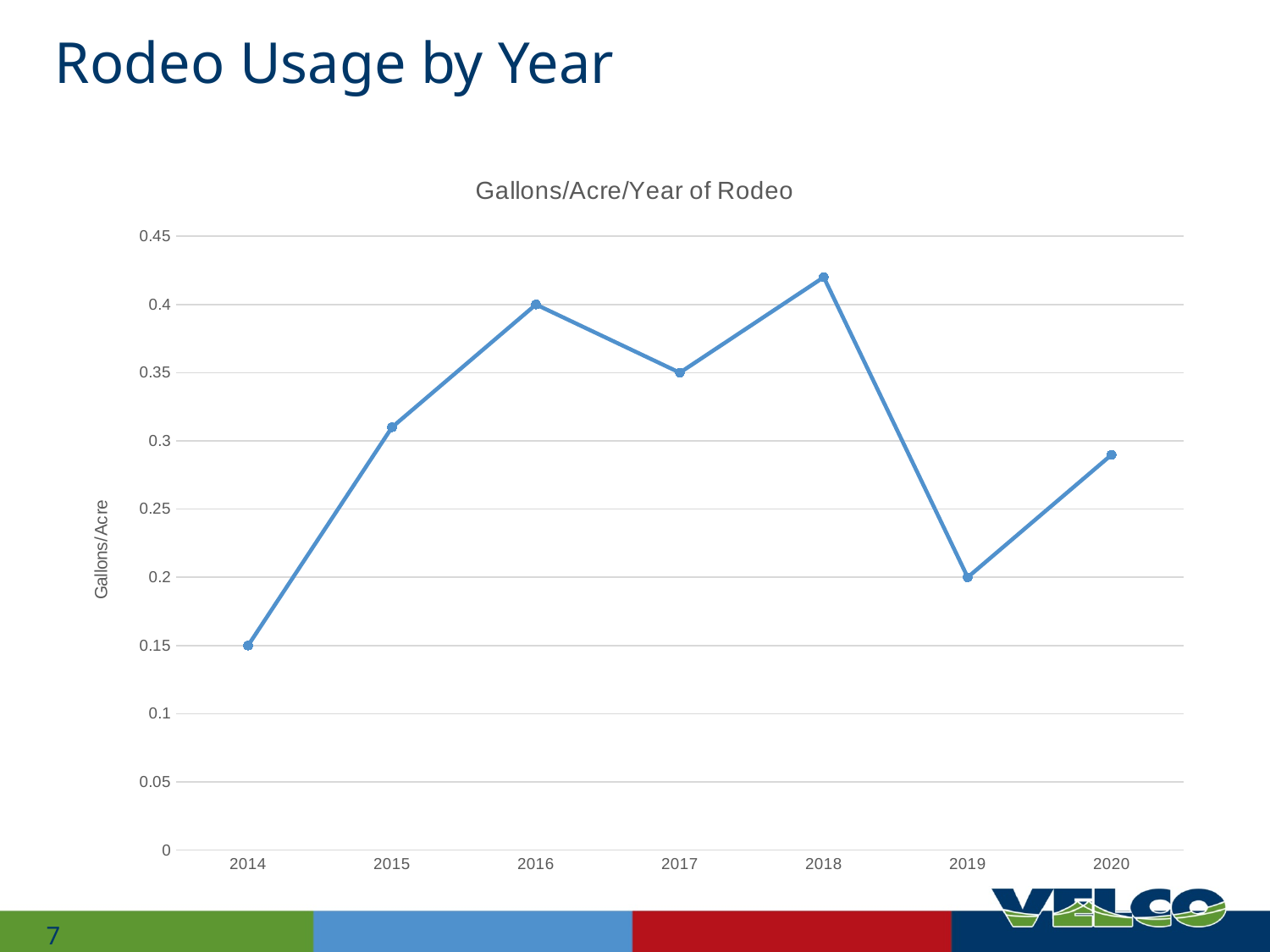
What is the difference between the values for 2016 and 2014? 0.25 What type of chart is shown on the slide? line chart What is the value for 2017? 0.35 Which year has the lowest value? 2014 What is the value for 2019? 0.2 What is the value for 2014? 0.15 How many years are plotted on the x axis? 7 What is the value for 2016? 0.4 What is the title of the chart? Gallons/Acre/Year of Rodeo Which year has the highest value? 2018